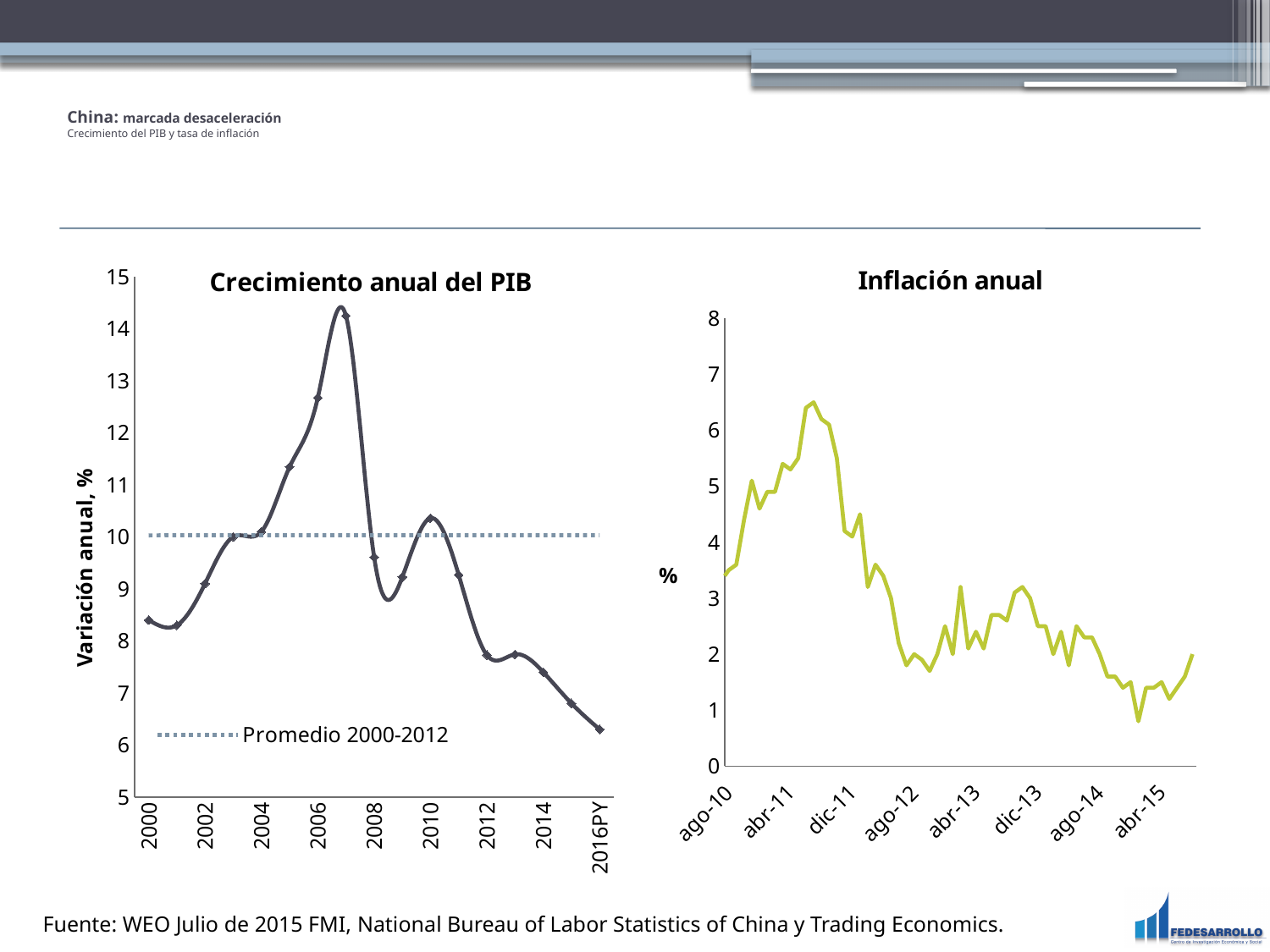
In the 'Crecimiento anual del PIB' chart, is the value for 2007 greater or less than 13? greater In the 'Crecimiento anual del PIB' chart, is the value for 2012 greater or less than 8? less In the 'Crecimiento anual del PIB' chart, which year has the lowest GDP growth? 2016PY In the 'Crecimiento anual del PIB' chart, which year has higher GDP growth, 2007 or 2010? 2007 What kind of chart is the 'Crecimiento anual del PIB' chart? line chart In the 'Crecimiento anual del PIB' chart, do the values rise or fall from 2010 to 2016PY? fall In the 'Crecimiento anual del PIB' chart, which year has the highest GDP growth? 2007 In the 'Inflación anual' chart, is the peak value reached in 2011 greater or less than 6? greater In the 'Crecimiento anual del PIB' chart, what does the dotted horizontal line represent? Promedio 2000-2012 What kind of chart is the 'Inflación anual' chart? line chart